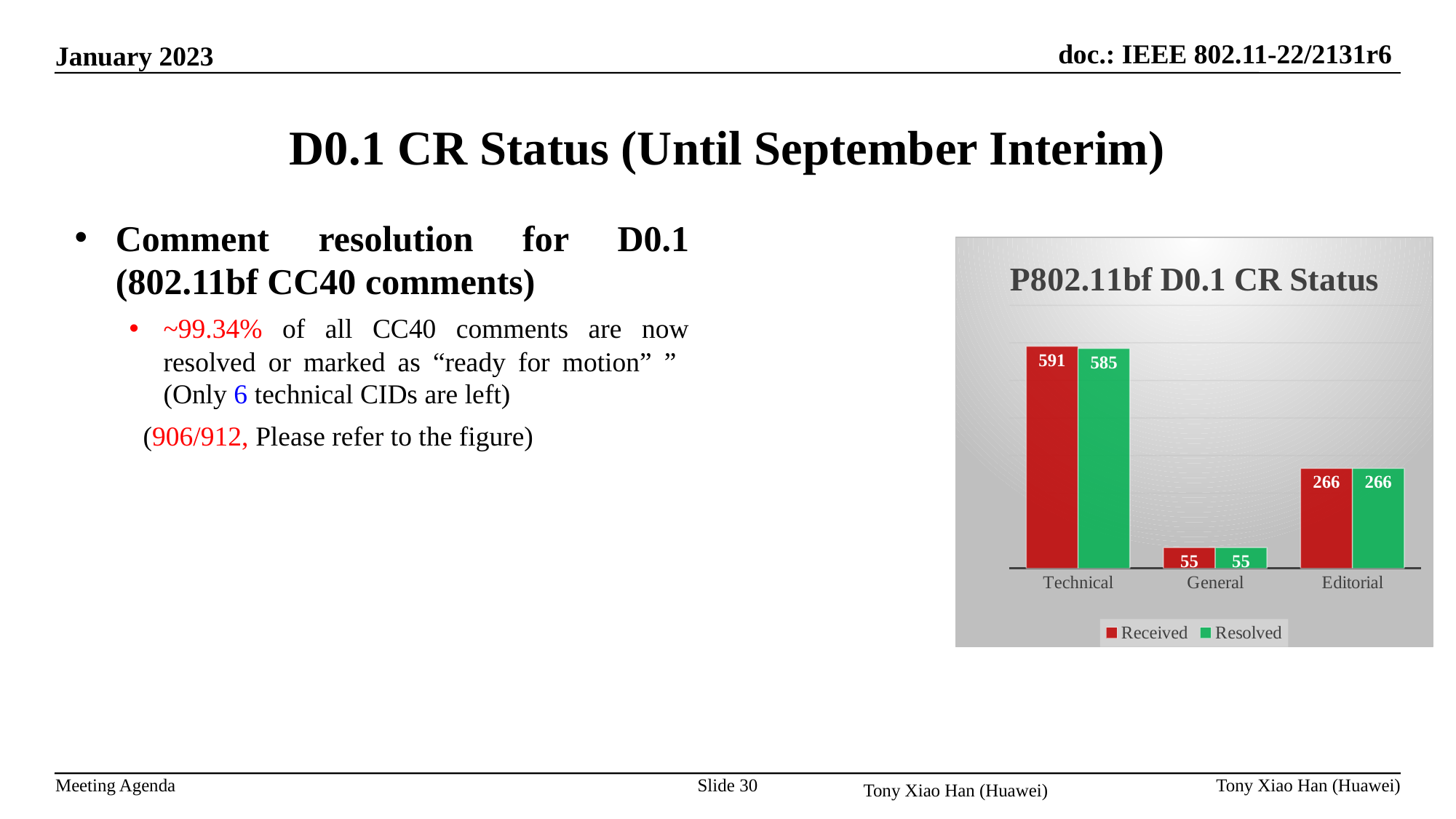
What is the Received value for General in the chart? 55 How many series does the legend of the chart list? 2 Which category has the lowest Resolved value in the chart? General What is the difference between the Received values for Technical and Editorial in the chart? 325 How many categories are shown on the x axis of the chart? 3 What is the difference between Received and Resolved for Technical in the chart? 6 Is the Received value for Technical larger than the Received value for Editorial in the chart? Yes What is the Resolved value for Editorial in the chart? 266 What is the Received value for Technical in the P802.11bf D0.1 CR Status chart? 591 Which category has the highest Received value in the chart? Technical What is the Resolved value for Technical in the chart? 585 What type of chart is shown on the slide? Bar chart